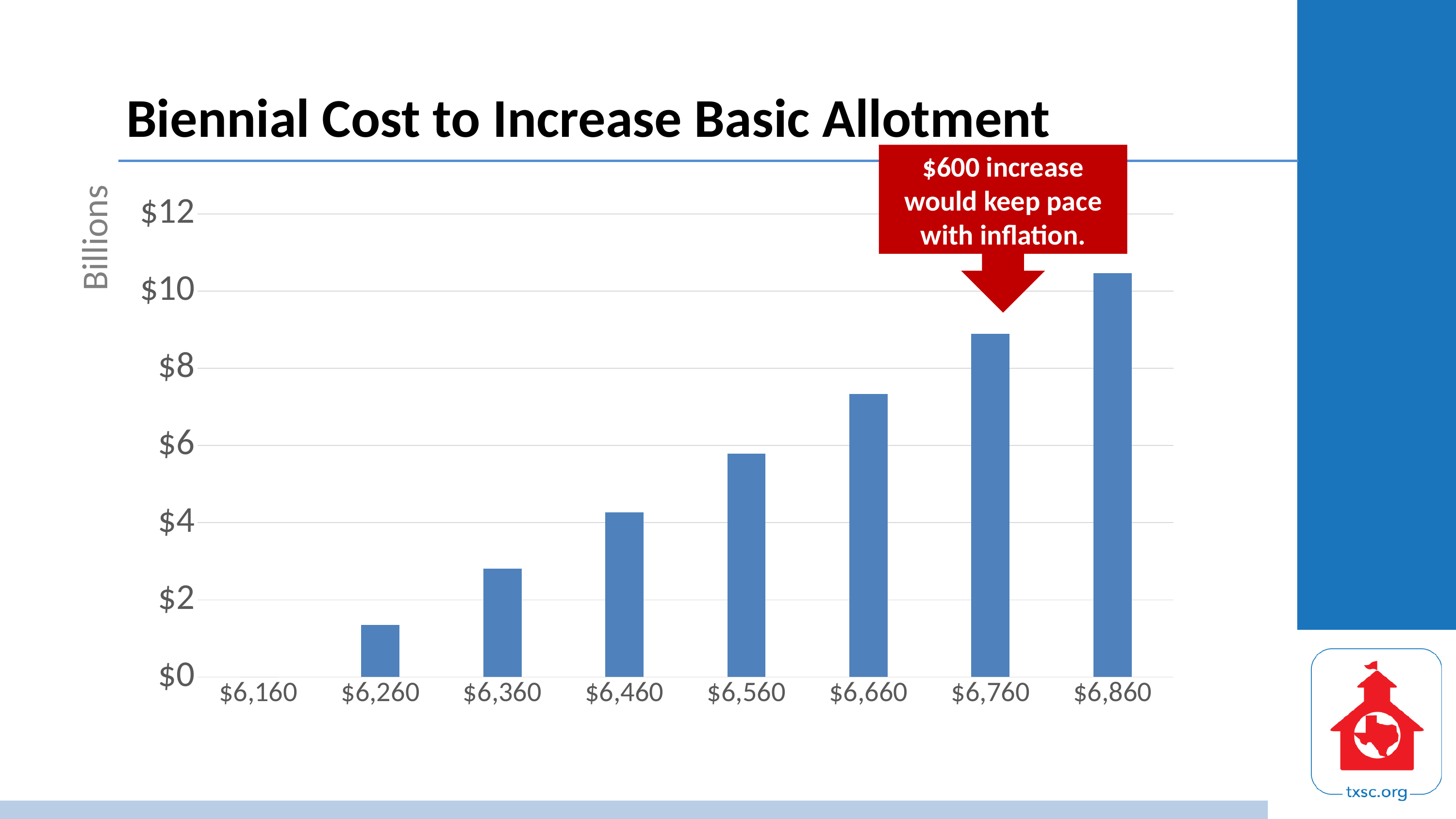
Is the biennial cost for $6,260 greater or less than $2 billion? less What kind of chart is shown on the slide? bar chart What is the label on the vertical axis of the chart? Billions Is the biennial cost for $6,860 greater or less than $10 billion? greater Is the biennial cost for $6,660 greater or less than $8 billion? less Which has the larger biennial cost, $6,560 or $6,360? $6,560 Which basic allotment level has the highest biennial cost? $6,860 How many basic allotment categories are shown on the x axis? 8 Which basic allotment level has the lowest biennial cost? $6,160 Do the biennial costs rise or fall as the basic allotment increases along the x axis? rise